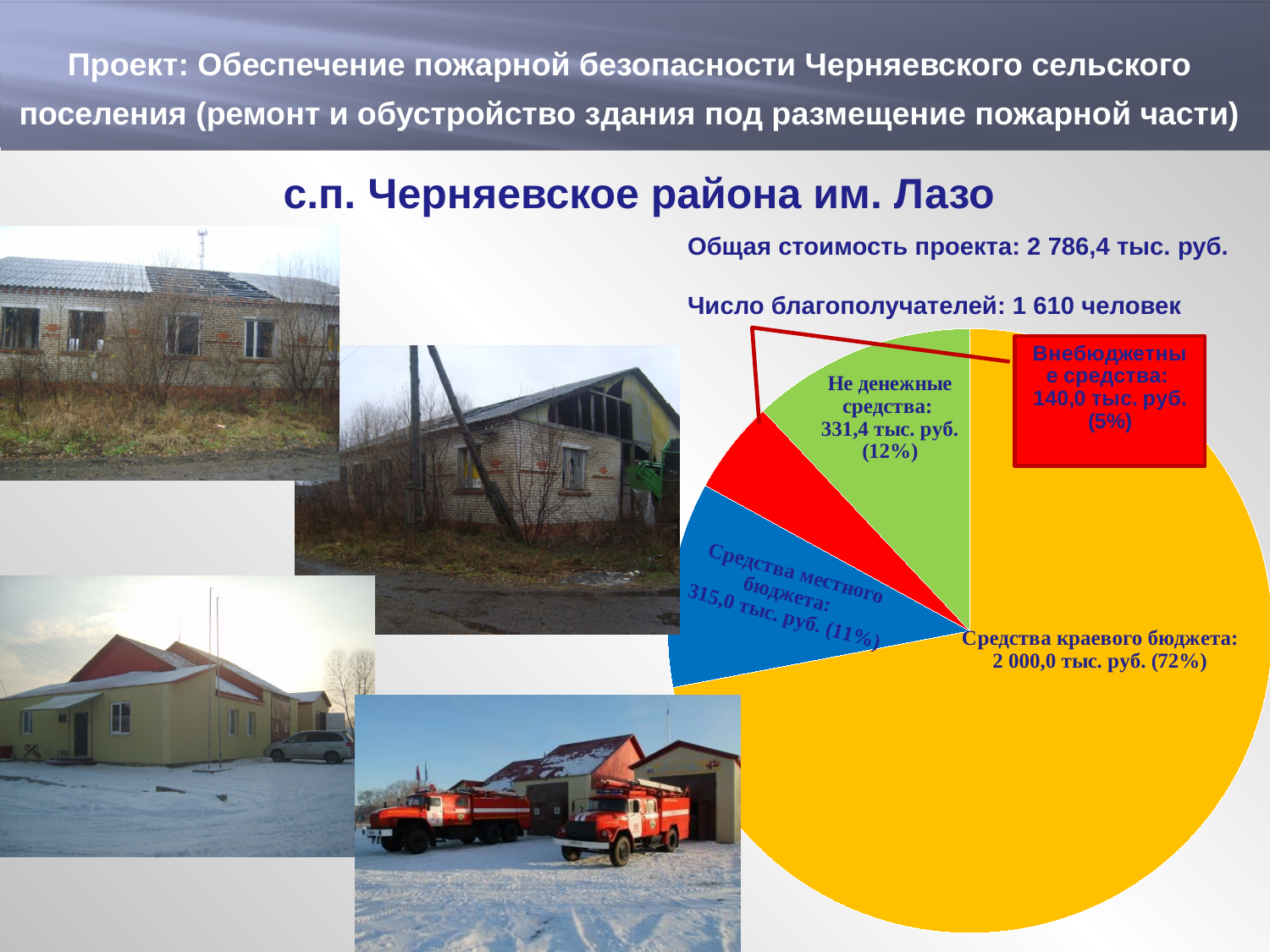
Which slice of the pie chart is the smallest? Внебюджетные средства What is the difference between Средства краевого бюджета and Внебюджетные средства in the pie chart? 1 860,0 тыс. руб. What is the value for Внебюджетные средства in the pie chart? 140,0 тыс. руб. Which slice of the pie chart is the largest? Средства краевого бюджета What is the value for Средства краевого бюджета in the pie chart? 2 000,0 тыс. руб. Which is larger in the pie chart: Не денежные средства or Средства местного бюджета? Не денежные средства What is the value for Не денежные средства in the pie chart? 331,4 тыс. руб. What is the value for Средства местного бюджета in the pie chart? 315,0 тыс. руб. What kind of chart is shown on the slide? pie chart What share of the pie does Средства краевого бюджета represent? 72% How many slices does the pie chart have? 4 What share of the pie does Средства местного бюджета represent? 11%